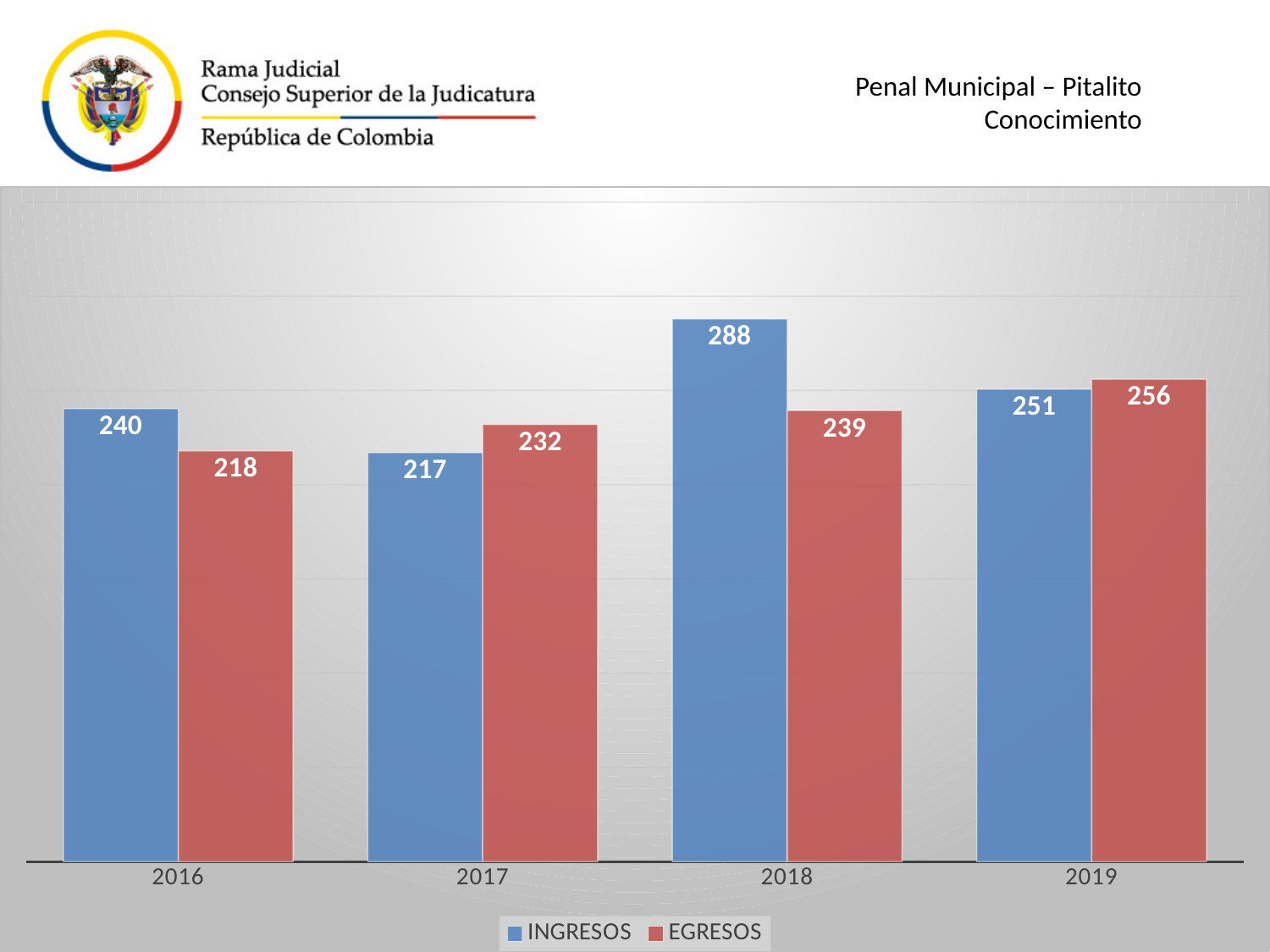
Which year has the highest INGRESOS value? 2018 What is the difference between INGRESOS and EGRESOS in 2018? 49 How many years are shown on the x axis? 4 Which year has the lowest EGRESOS value? 2016 What is the difference between EGRESOS in 2019 and EGRESOS in 2017? 24 What kind of chart is shown on the slide? Bar chart In 2017, which is larger, INGRESOS or EGRESOS? EGRESOS What is the EGRESOS value for 2019? 256 What is the INGRESOS value for 2018? 288 Which colour represents EGRESOS in the chart? Red How many series does the legend list? 2 What is the EGRESOS value for 2016? 218